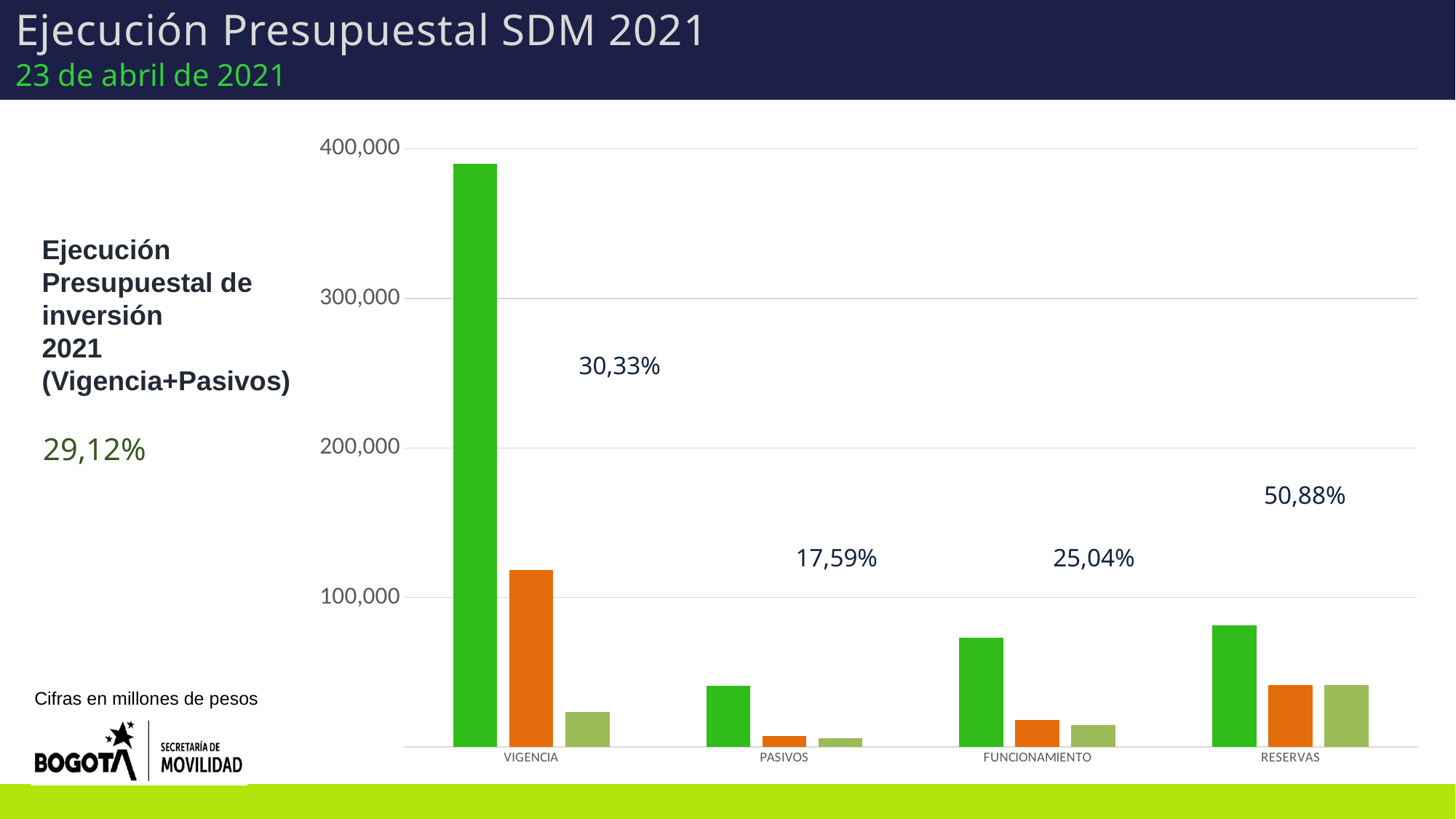
What percentage label is shown above the VIGENCIA group? 30,33% How many categories are shown on the x axis of the chart? 4 Which category has the highest percentage label? RESERVAS Which category contains the tallest bar in the chart? VIGENCIA What percentage label is shown above the PASIVOS group? 17,59% Is the value of the tallest bar in the VIGENCIA group greater or less than 300,000? greater What kind of chart is shown on the slide? bar chart What is the difference between the percentage labels for RESERVAS and PASIVOS? 33,29% Which category has the lowest percentage label? PASIVOS What percentage label is shown above the FUNCIONAMIENTO group? 25,04% What percentage label is shown above the RESERVAS group? 50,88% Is the value of the tallest bar in the PASIVOS group greater or less than 100,000? less